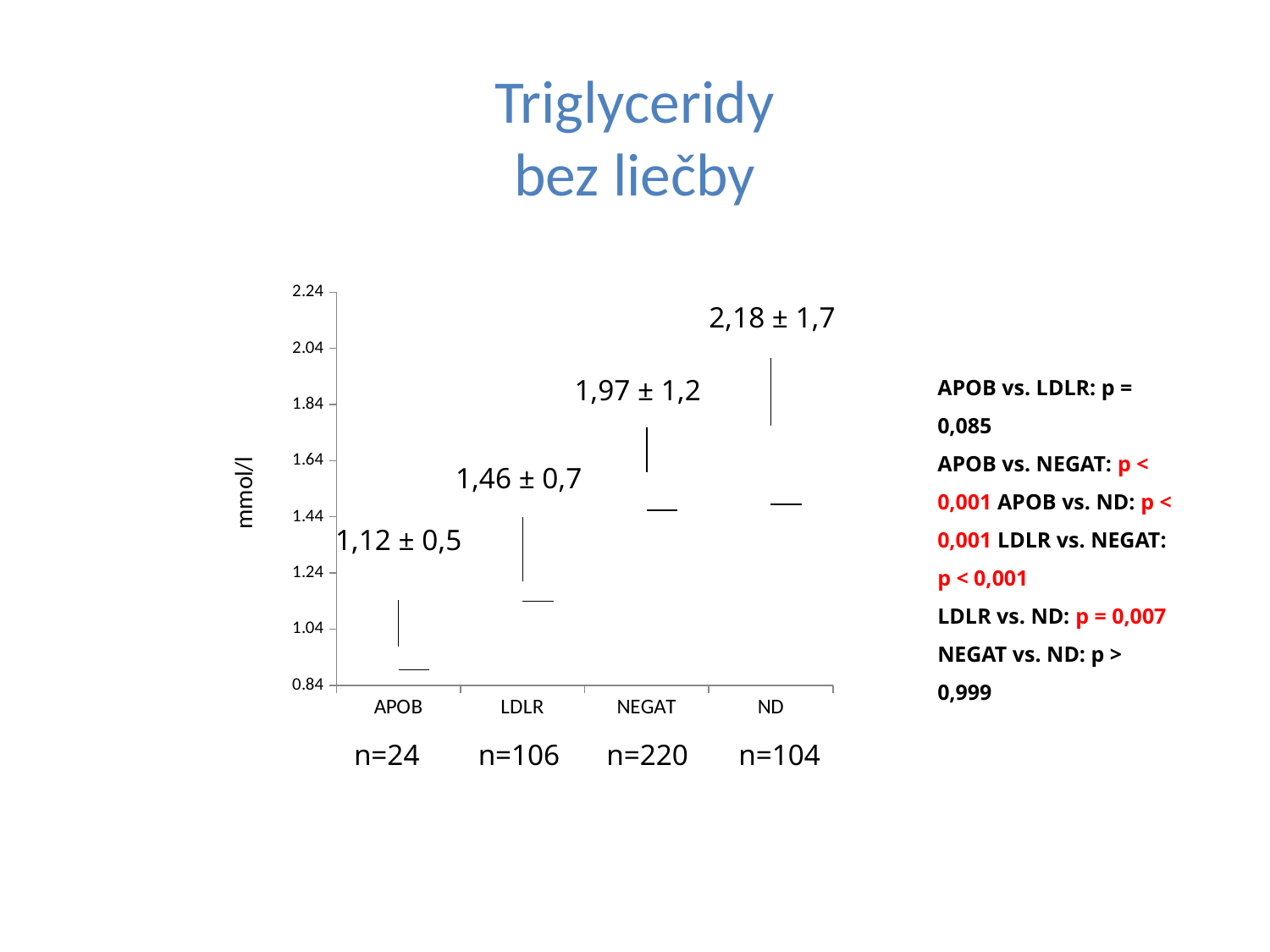
What is the value label shown for NEGAT? 1,97 ± 1,2 Which category has the lowest mean value? APOB What is the value label shown for ND? 2,18 ± 1,7 How many categories are shown on the x axis? 4 What is the sample size (n) shown for NEGAT? n=220 What is the value label shown for LDLR? 1,46 ± 0,7 Which category has the highest mean value? ND What is the label on the y axis? mmol/l Do the mean values rise or fall from APOB to ND along the x axis? rise Which has the larger mean value, LDLR or NEGAT? NEGAT What is the difference between the mean values of ND and APOB? 1,06 What is the value label shown for APOB? 1,12 ± 0,5